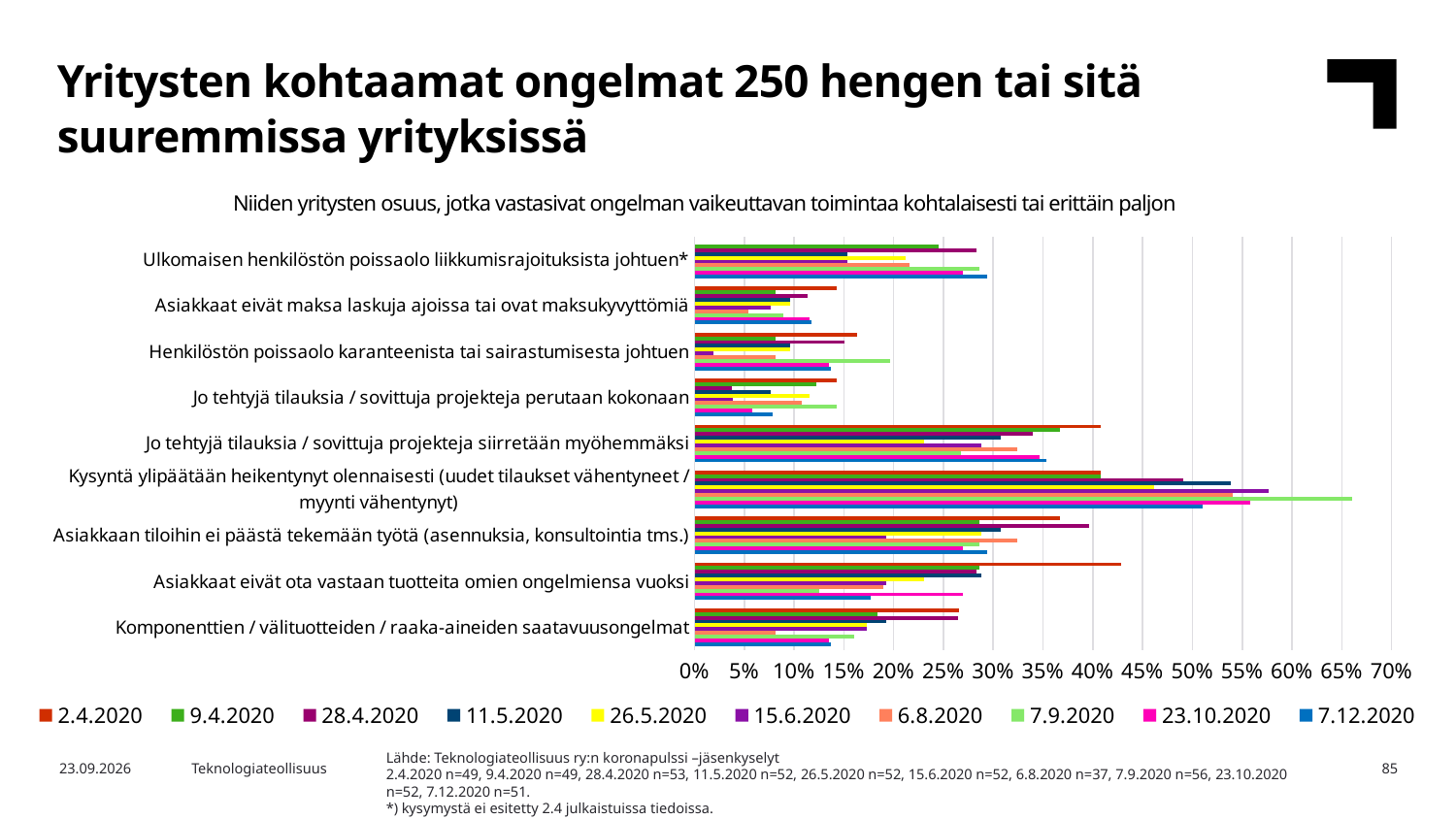
How many series (survey dates) does the legend list? 10 Is the 7.9.2020 value for 'Kysyntä ylipäätään heikentynyt olennaisesti' greater or less than 60%? greater Is the 2.4.2020 value for 'Asiakkaat eivät ota vastaan tuotteita omien ongelmiensa vuoksi' greater or less than 40%? greater How many categories (problem types) are listed on the vertical axis of the chart? 9 What is the highest tick value shown on the horizontal axis of the chart? 70% Is the 2.4.2020 value for 'Asiakkaat eivät maksa laskuja ajoissa tai ovat maksukyvyttömiä' greater or less than 20%? less What kind of chart is shown on the slide? bar chart Which category has the highest values overall in the chart? Kysyntä ylipäätään heikentynyt olennaisesti (uudet tilaukset vähentyneet / myynti vähentynyt) For 'Kysyntä ylipäätään heikentynyt olennaisesti', which is larger: the 7.9.2020 value or the 2.4.2020 value? 7.9.2020 For the 2.4.2020 series, which is larger: 'Asiakkaat eivät ota vastaan tuotteita omien ongelmiensa vuoksi' or 'Komponenttien / välituotteiden / raaka-aineiden saatavuusongelmat'? Asiakkaat eivät ota vastaan tuotteita omien ongelmiensa vuoksi What is the first series listed in the chart legend? 2.4.2020